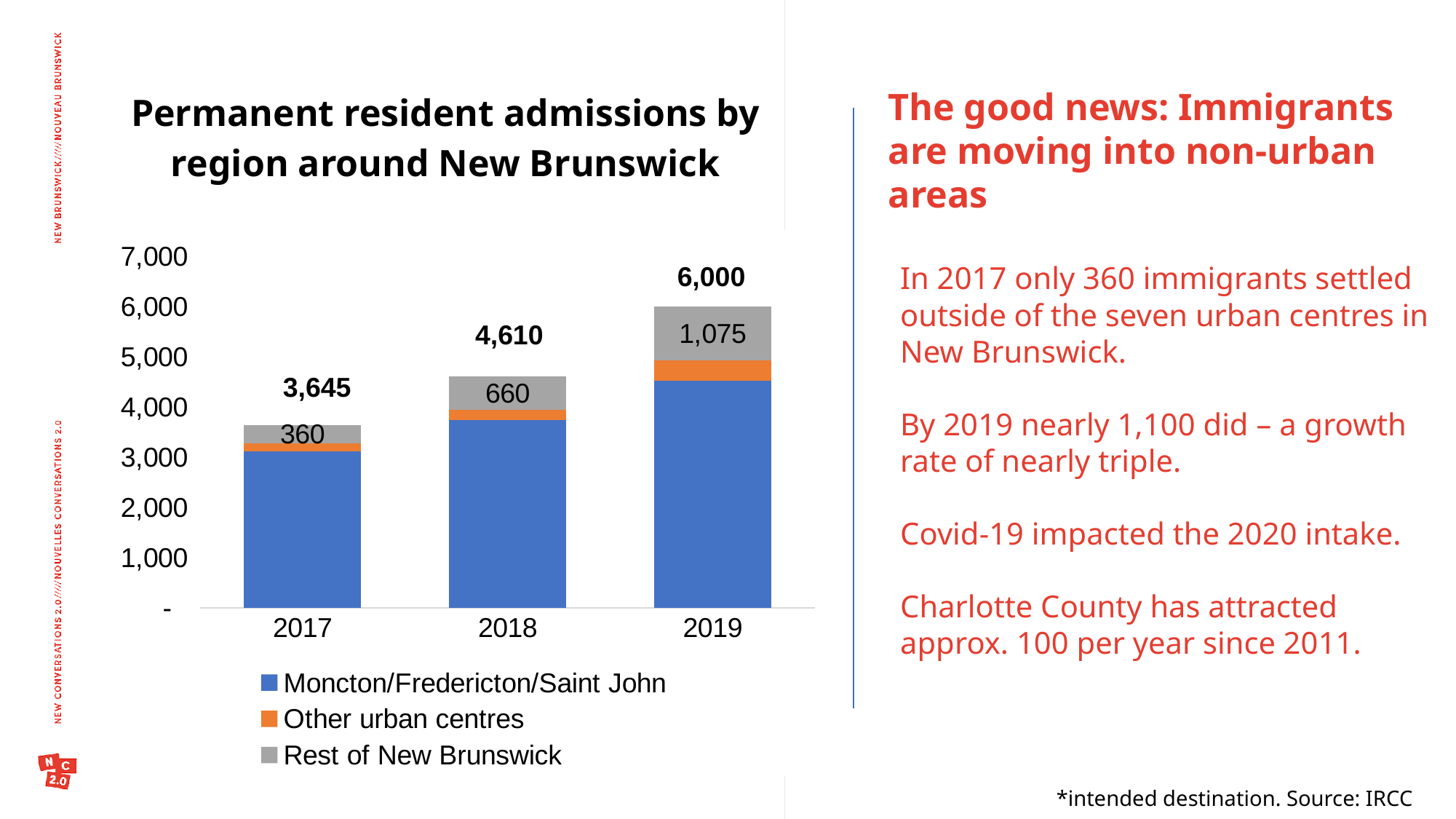
Do the total admissions rise or fall from 2017 to 2019? rise Is the Rest of New Brunswick value larger in 2018 or 2017? 2018 Which year has the highest total admissions? 2019 What is the value for Rest of New Brunswick in 2019? 1,075 Is the value for Moncton/Fredericton/Saint John in 2019 greater or less than 4,000? greater What is the difference between the total admissions in 2019 and 2018? 1,390 What is the difference between the Rest of New Brunswick values in 2019 and 2017? 715 Which year has the lowest total admissions? 2017 What is the total permanent resident admissions shown for 2019? 6,000 What is the total permanent resident admissions shown for 2017? 3,645 What is the value for Rest of New Brunswick in 2018? 660 How many series does the legend list? 3